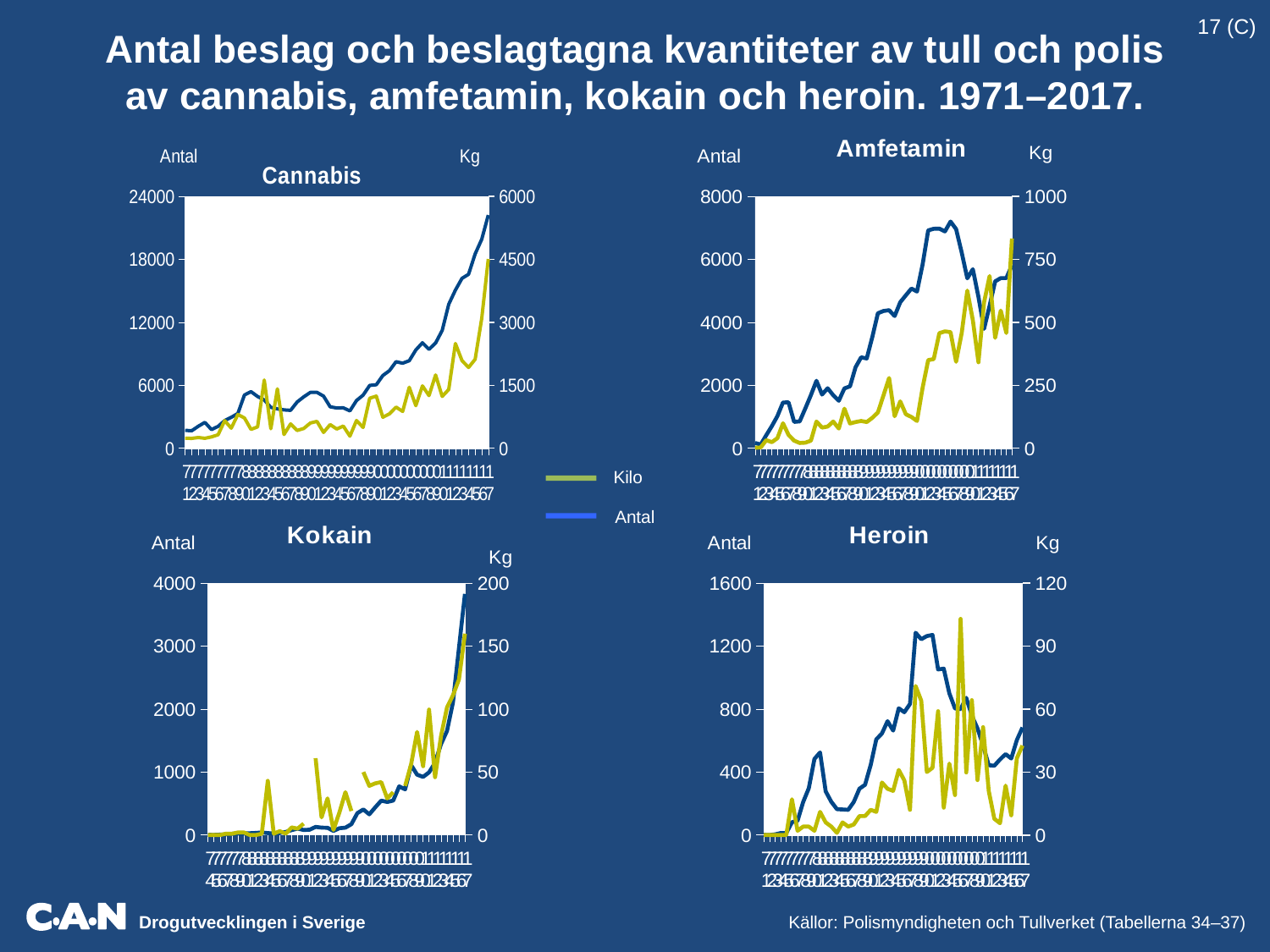
What kind of chart is the Cannabis chart? line chart In the Cannabis chart, is the Antal value at the end of the series (2017) greater or less than 18000? greater What is the highest value shown on the Kg axis of the Heroin chart? 120 In the Cannabis chart, is the Kg value at the end of the series greater or less than 3000? greater In the Kokain chart, is the Antal value at the end of the series greater or less than 3000? greater In the Cannabis chart, does the Antal series overall rise or fall from 1971 to 2017? rise How many series does the legend list? 2 What are the two entries in the legend? Kilo and Antal